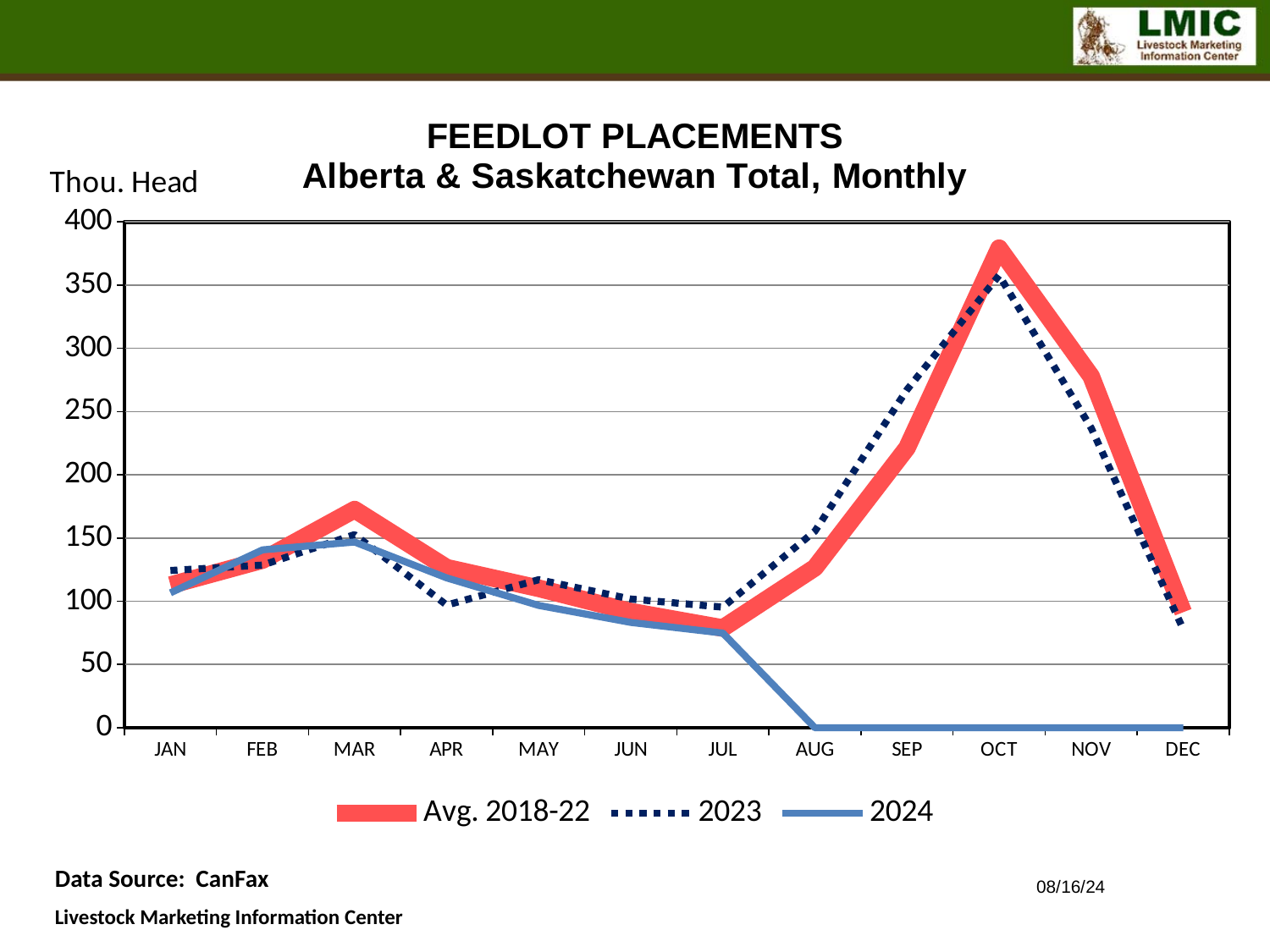
In OCT, which series is higher: Avg. 2018-22 or 2023? Avg. 2018-22 In which month does the Avg. 2018-22 series reach its highest value? OCT What unit is given for the y axis of the chart? Thou. Head Is the 2024 value for JUL greater or less than 100? less How many months are shown along the x axis? 12 Is the Avg. 2018-22 value for MAR greater or less than 150? greater In which month is the Avg. 2018-22 series at its lowest? JUL How many series does the legend list? 3 What kind of chart is shown on the slide? line chart Is the Avg. 2018-22 value for OCT greater or less than 350? greater In which month does the 2023 series reach its highest value? OCT Does the Avg. 2018-22 series rise or fall from JUL to OCT? rise